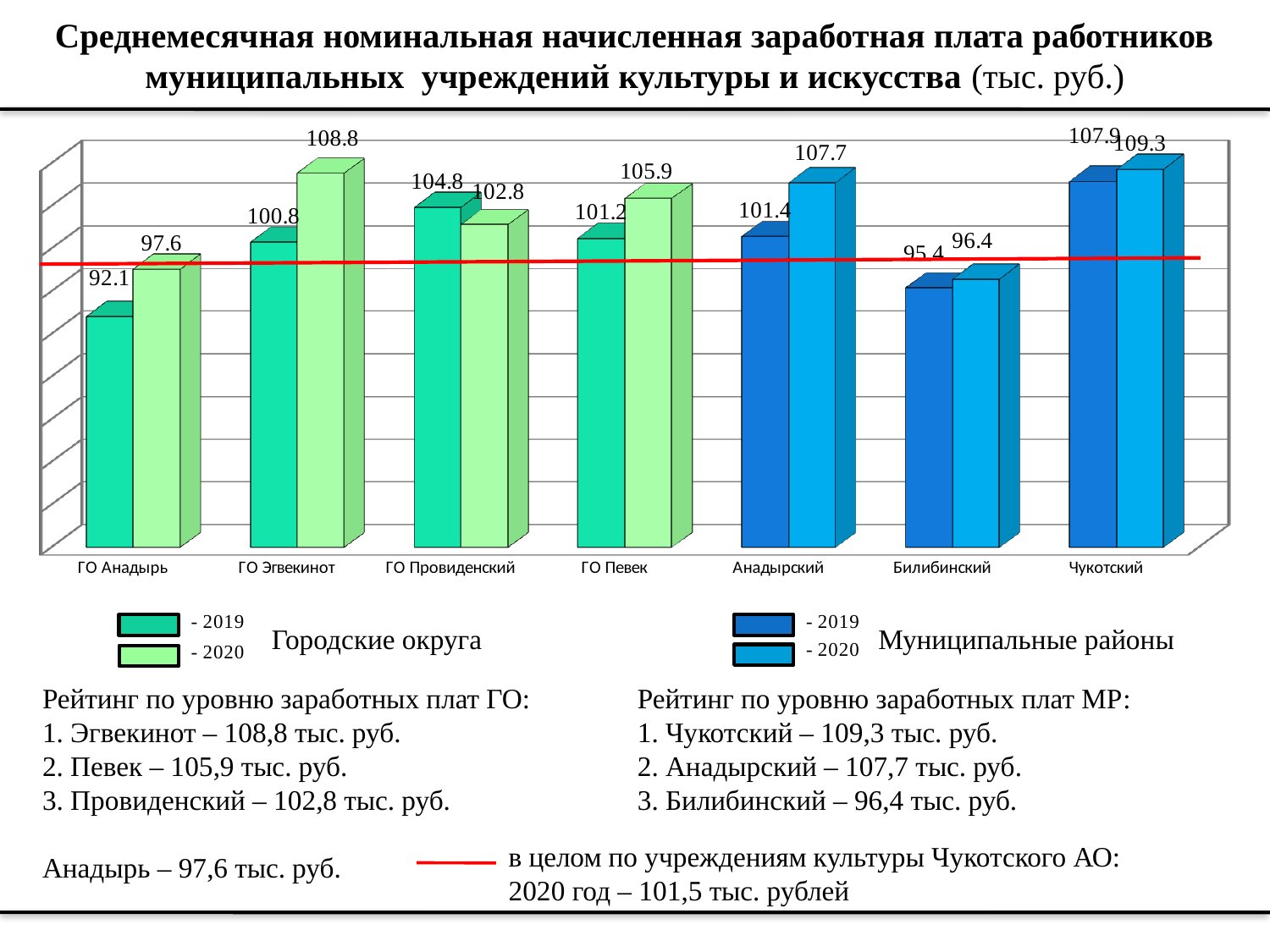
How many categories are shown on the x axis of the chart? 7 Which category has the highest 2020 value? Чукотский What is the difference between the 2019 and 2020 values for ГО Провиденский? 2.0 What is the 2019 value for ГО Анадырь? 92.1 Which is larger: the 2020 value for ГО Певек or the 2020 value for Билибинский? ГО Певек What value does the red horizontal line represent, according to the slide? 101,5 тыс. рублей Which category has the lowest 2019 value? ГО Анадырь What is the 2020 value for ГО Эгвекинот? 108.8 Which is larger for ГО Провиденский: the 2019 value or the 2020 value? 2019 What kind of chart is shown on the slide? bar chart What is the 2020 value for Анадырский? 107.7 What is the difference between the 2020 and 2019 values for ГО Эгвекинот? 8.0